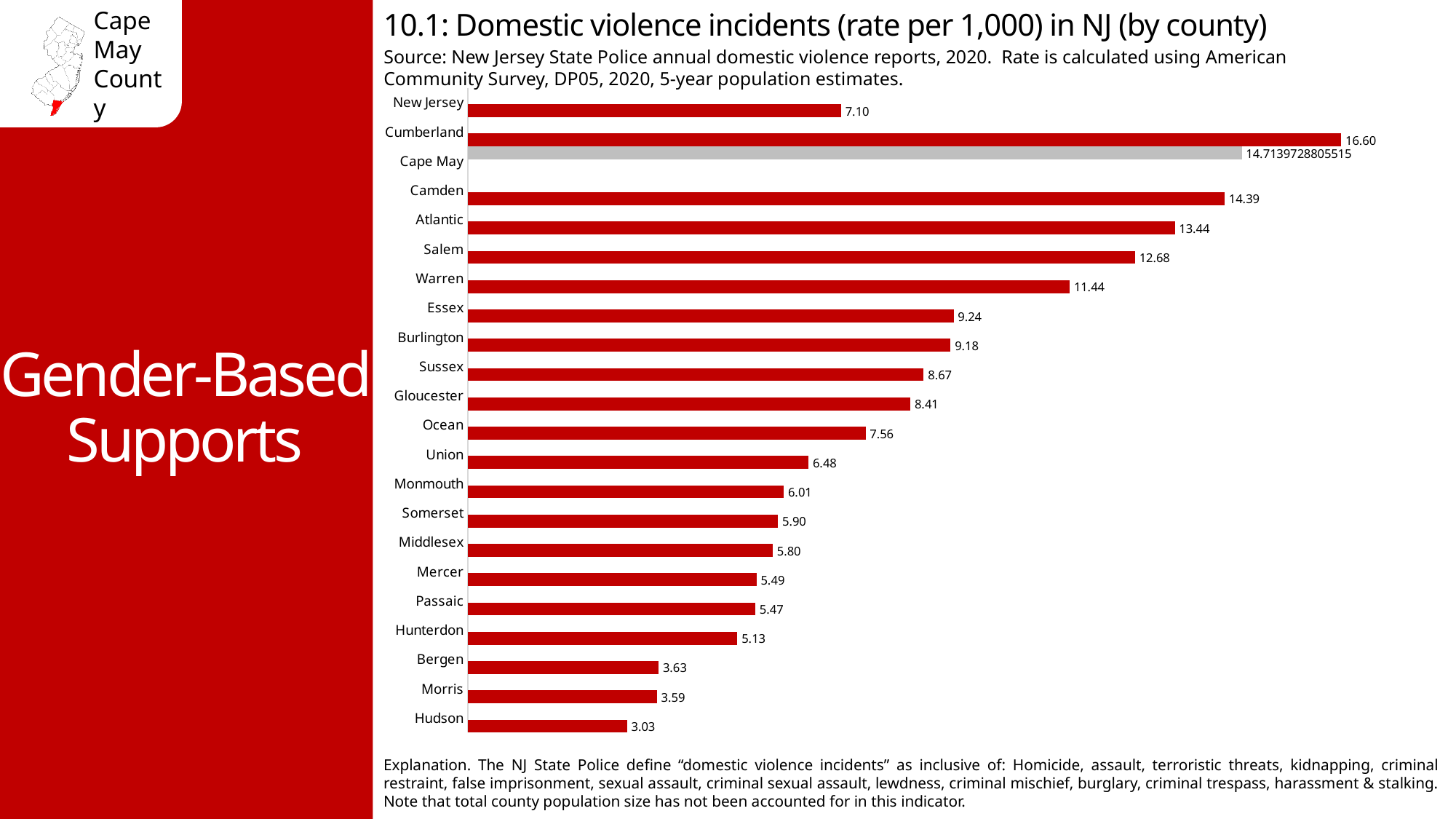
What type of chart is shown on the slide? Bar chart What is the value shown for Cape May? 14.7139728805515 Which has a higher rate, Ocean or Union? Ocean Which has a higher rate, Atlantic or Salem? Atlantic Which county has the lowest domestic violence incident rate? Hudson Which county has the highest domestic violence incident rate? Cumberland What is the rate shown for New Jersey overall? 7.10 What is the domestic violence incident rate for Cumberland? 16.60 Which bar is coloured grey instead of red? Cape May What is the difference between the New Jersey rate and the Hudson rate? 4.07 How many bars (categories) are shown in the chart? 22 What is the difference between the rates for Cumberland and Camden? 2.21